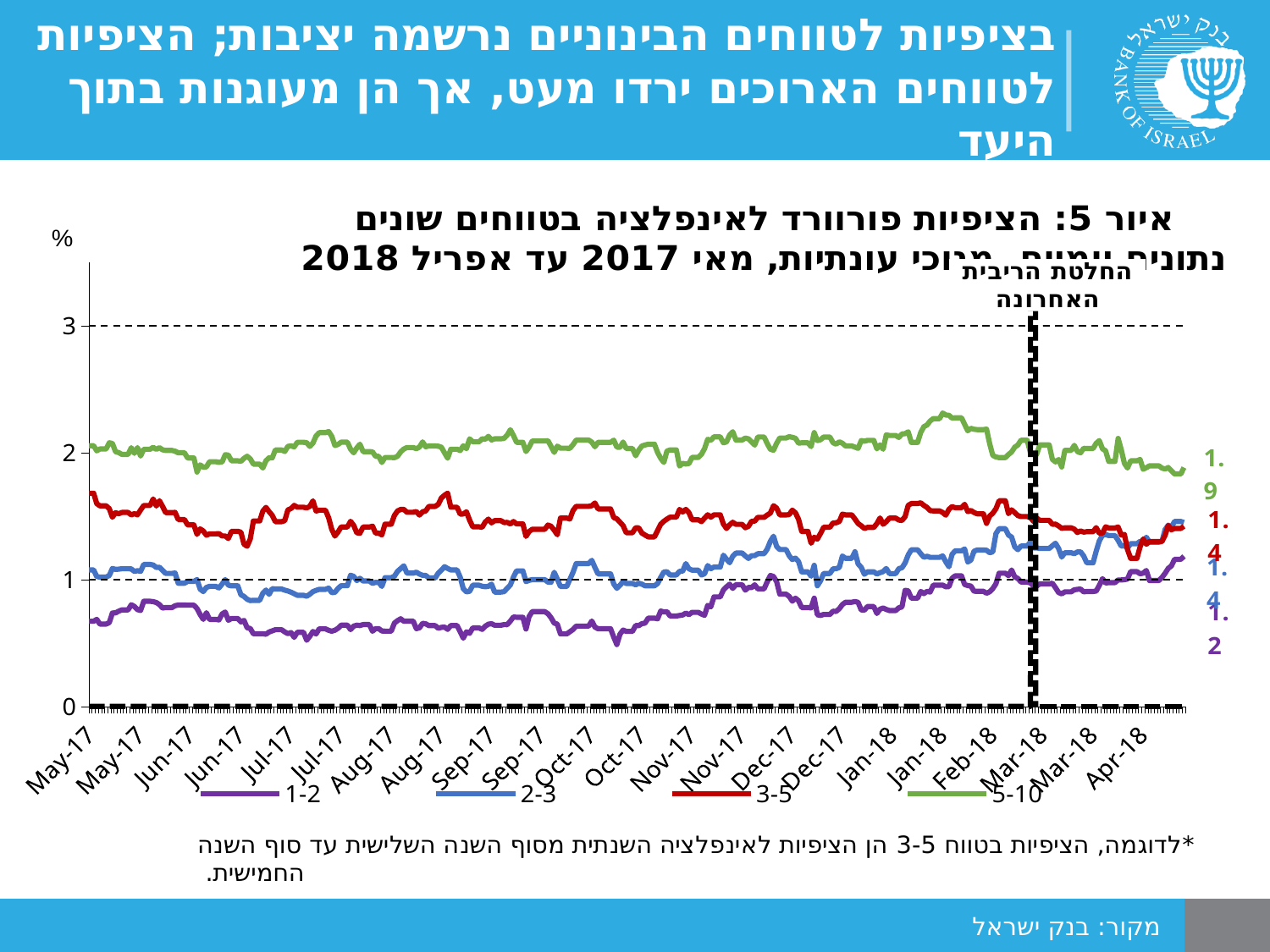
How many series does the legend list? 4 Which series has the lowest values across the whole period? 1-2 In Jul-17, which is larger: the 3-5 series or the 2-3 series? 3-5 Does the 1-2 series rise or fall overall from May-17 to Apr-18? rises What is the value labelled at the end of the 5-10 series? 1.9 What are the four series listed in the legend? 1-2, 2-3, 3-5, 5-10 What unit is shown on the y axis? % Is the value of the 5-10 series in Jan-18 greater or less than 2? greater Is the value of the 1-2 series in May-17 greater or less than 1? less What kind of chart is shown on the slide? line chart What is the value labelled at the end of the 1-2 series? 1.2 Which series has the highest values across the whole period? 5-10